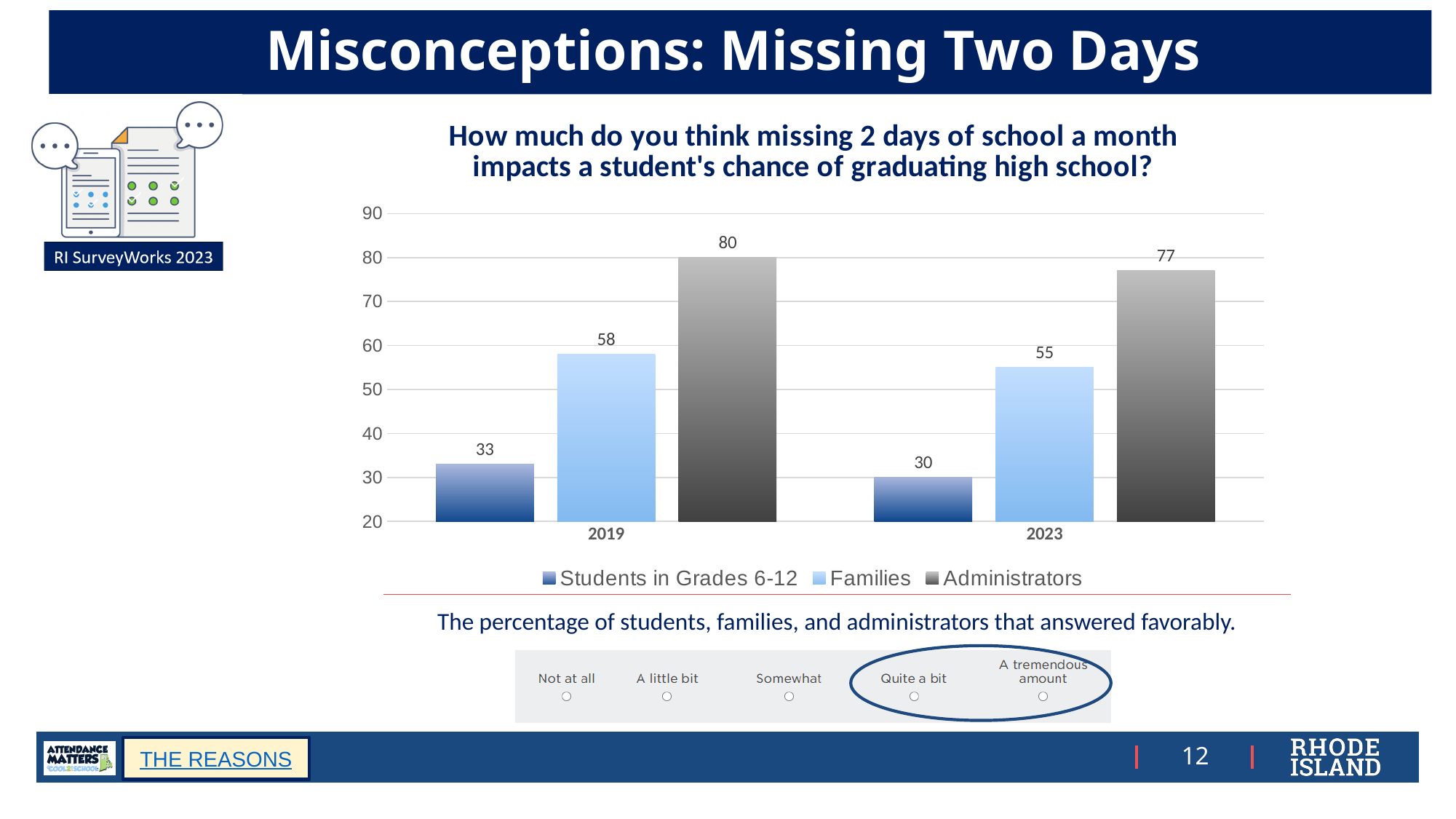
Do the values for Students in Grades 6-12 rise or fall from 2019 to 2023? Fall What is the difference between the Administrators values in 2019 and 2023? 3 What value is shown for Administrators in 2019? 80 Which series has the lowest value in 2019? Students in Grades 6-12 What kind of chart is shown on the slide? Bar chart Which series has the highest value in 2023? Administrators How many series does the legend list? 3 What is the difference between the Families and Students in Grades 6-12 values in 2023? 25 Which is larger: Families in 2019 or Families in 2023? Families in 2019 How many year categories are shown on the x axis? 2 What value is shown for Students in Grades 6-12 in 2019? 33 What value is shown for Families in 2023? 55